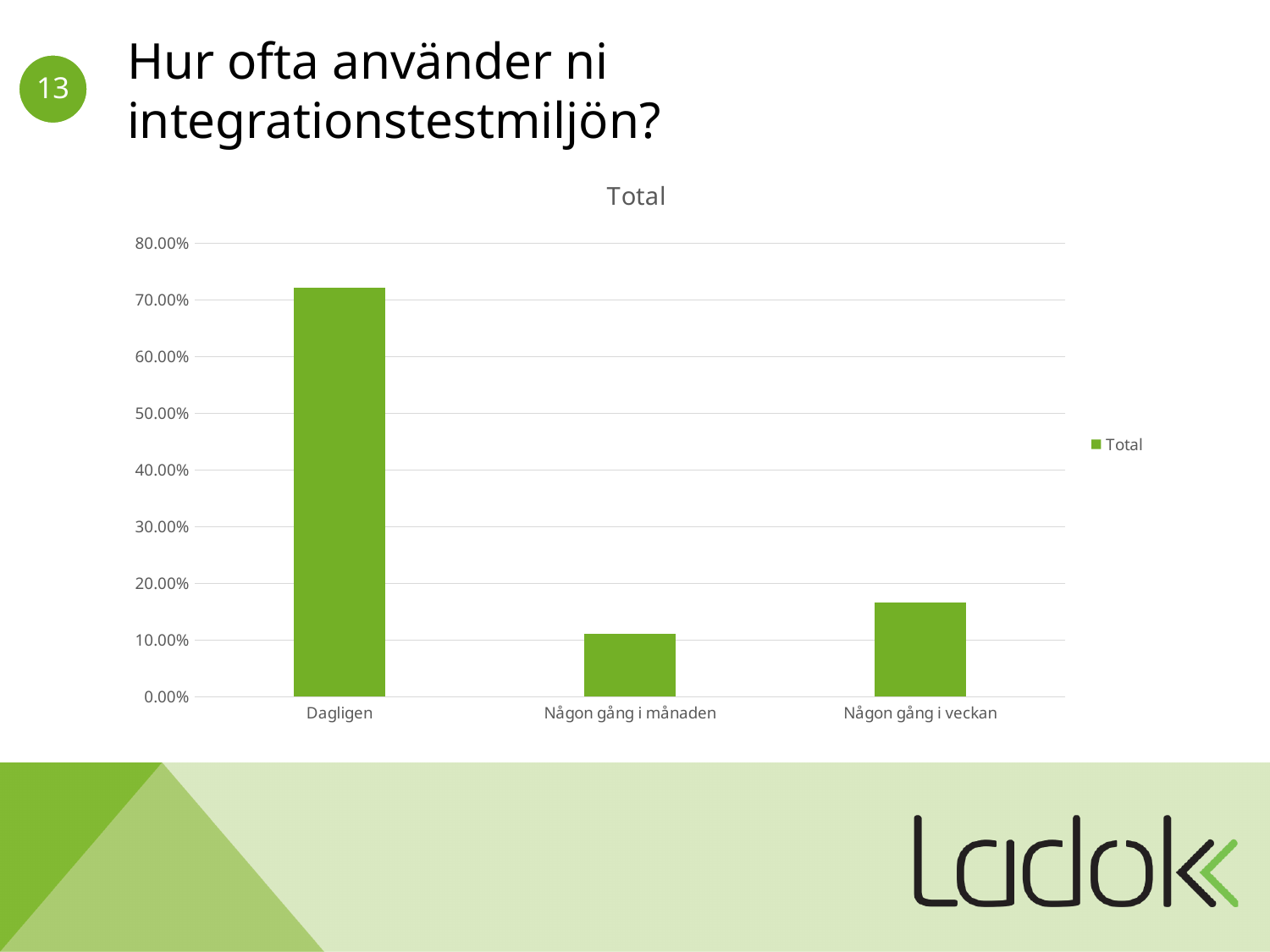
How many categories are shown on the x axis? 3 Which is larger, the value for Någon gång i veckan or the value for Någon gång i månaden? Någon gång i veckan What is the title of the chart? Total Is the value for Någon gång i månaden greater or less than 20.00%? less How many series does the legend list? 1 Is the value for Någon gång i veckan greater or less than 10.00%? greater Is the value for Dagligen greater or less than 80.00%? less Which category has the lowest value? Någon gång i månaden Which category has the highest value? Dagligen Which is larger, the value for Dagligen or the value for Någon gång i veckan? Dagligen What kind of chart is shown on the slide? bar chart